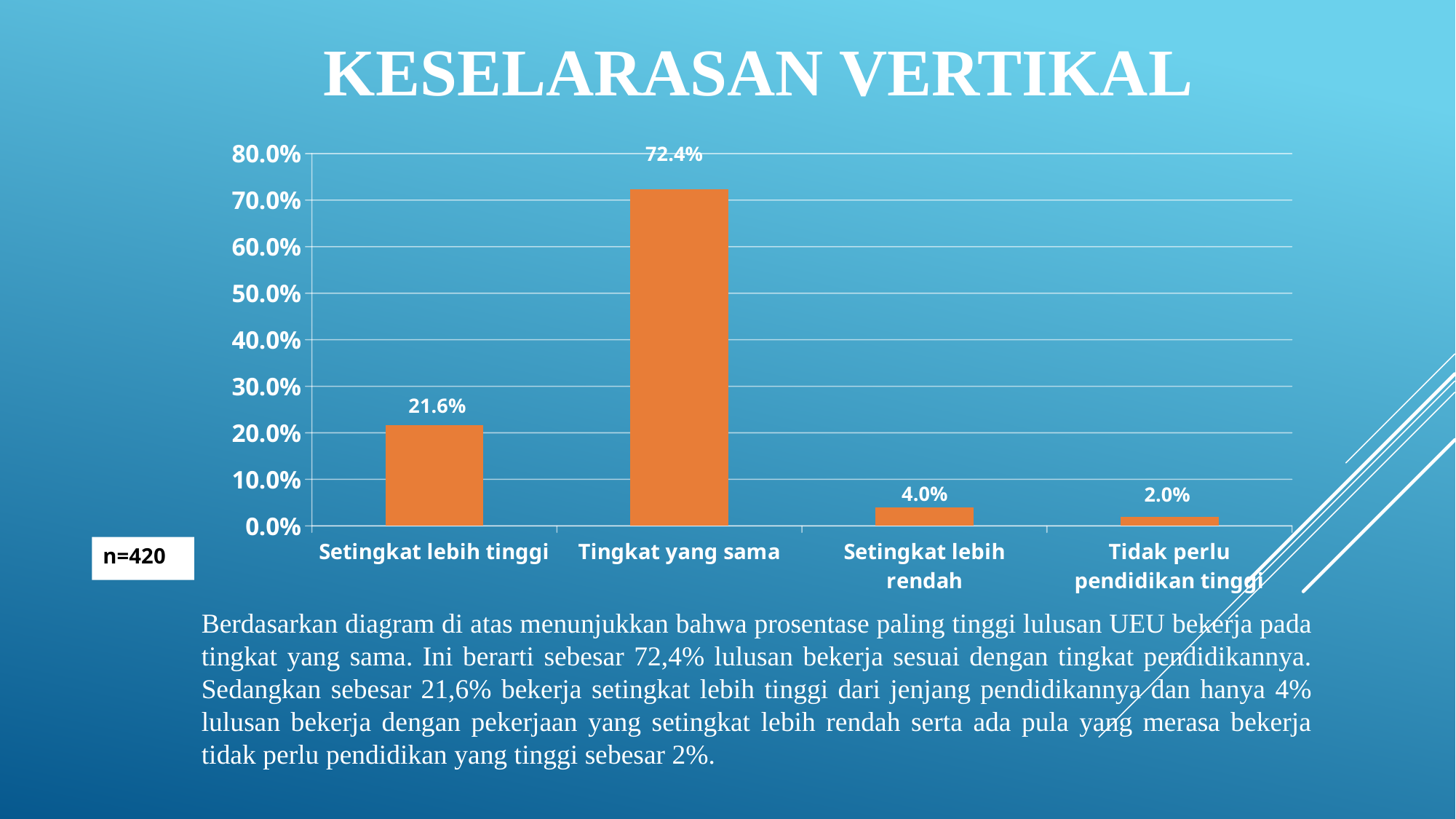
What is the value for Setingkat lebih tinggi? 21.6% Is the value for Setingkat lebih tinggi greater or less than 30.0%? less Which category has the lowest value? Tidak perlu pendidikan tinggi What is the value for Setingkat lebih rendah? 4.0% What kind of chart is shown on the slide? bar chart Which is larger, the value for Setingkat lebih rendah or the value for Tidak perlu pendidikan tinggi? Setingkat lebih rendah Which category has the highest value? Tingkat yang sama What is the value for Tingkat yang sama? 72.4% What sample size is shown next to the chart? n=420 What is the difference between the values for Tingkat yang sama and Setingkat lebih tinggi? 50.8% What is the value for Tidak perlu pendidikan tinggi? 2.0% How many categories are shown on the x axis? 4